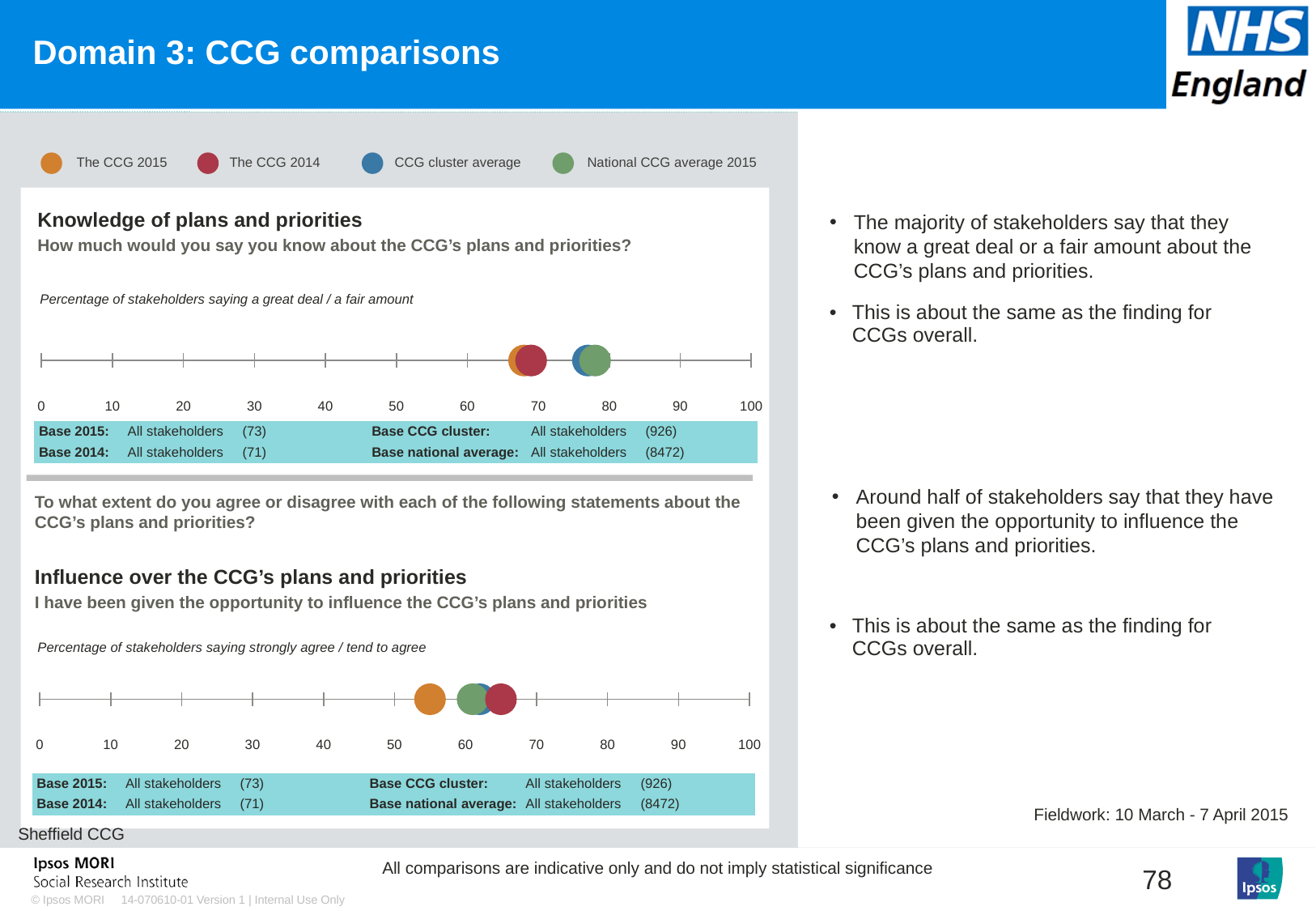
What colour represents The CCG 2015 in the legend? Orange How many series does the legend list for the charts on this slide? 4 In the 'Knowledge of plans and priorities' chart, is the value for The CCG 2015 greater or less than 80? less In the 'Knowledge of plans and priorities' chart, is the value for National CCG average 2015 greater or less than 70? greater In the 'Knowledge of plans and priorities' chart, is the value for The CCG 2015 greater or less than 50? greater What is the maximum value shown on the x axis of the 'Knowledge of plans and priorities' chart? 100 What kind of chart is used for 'Knowledge of plans and priorities'? Dot plot In the 'Knowledge of plans and priorities' chart, which is larger: The CCG 2015 or National CCG average 2015? National CCG average 2015 In the 'Influence over the CCG's plans and priorities' chart, which is larger: The CCG 2015 or The CCG 2014? The CCG 2014 In the 'Influence over the CCG's plans and priorities' chart, which series has the lowest value? The CCG 2015